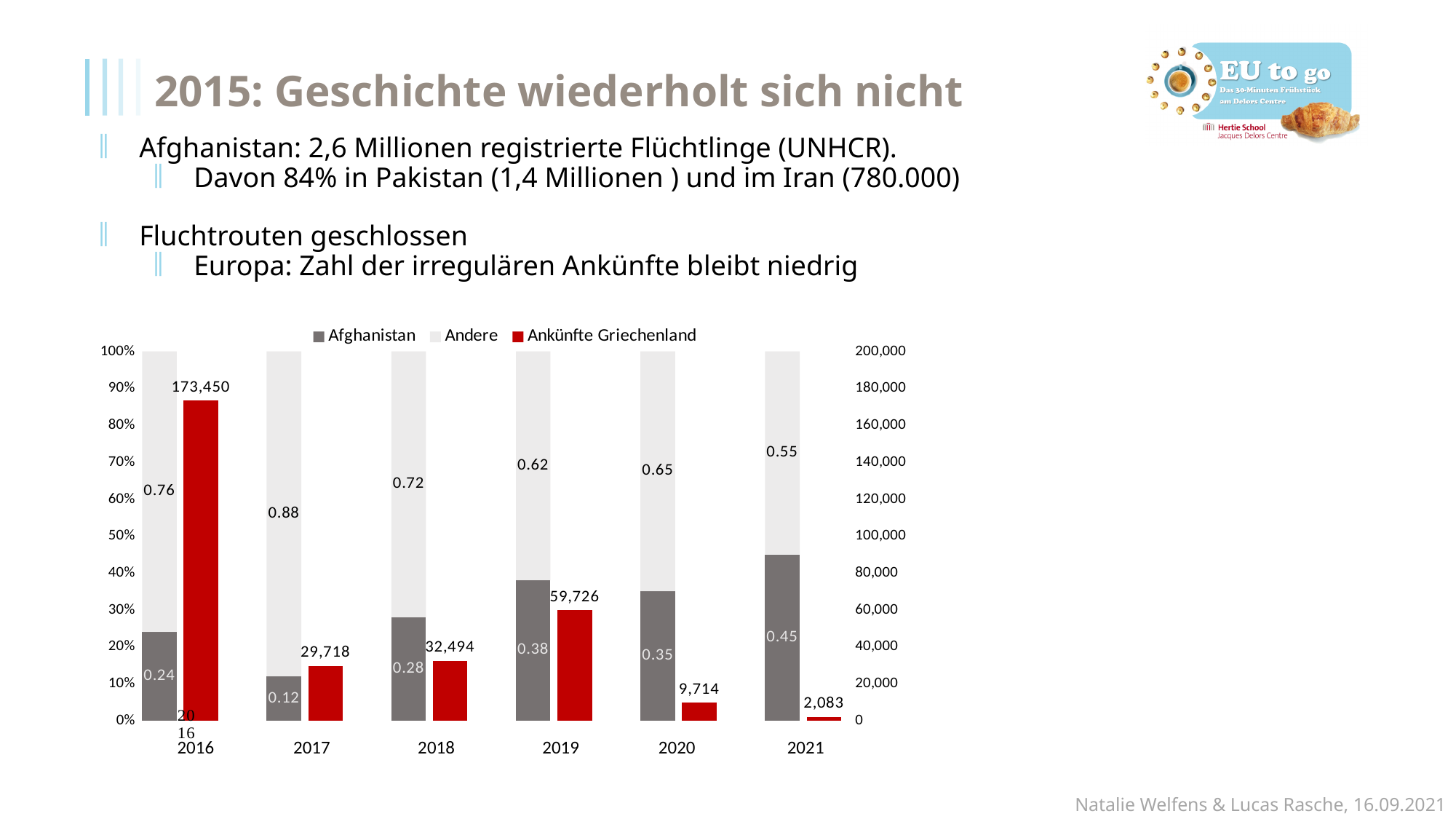
What kind of chart is shown on the slide? bar chart In which year is the Ankünfte Griechenland value lowest? 2021 In which year is the Afghanistan share lowest? 2017 Which series is shown in red in the legend? Ankünfte Griechenland How many years are shown on the x axis? 6 In which year is the Ankünfte Griechenland value highest? 2016 What is the Andere value shown for 2017? 0.88 What is the value for Ankünfte Griechenland in 2016? 173,450 How many series does the legend list? 3 What is the difference between the Ankünfte Griechenland values for 2019 and 2020? 50,012 Which is larger, the Ankünfte Griechenland value for 2017 or for 2018? 2018 What is the Afghanistan share shown for 2021? 0.45